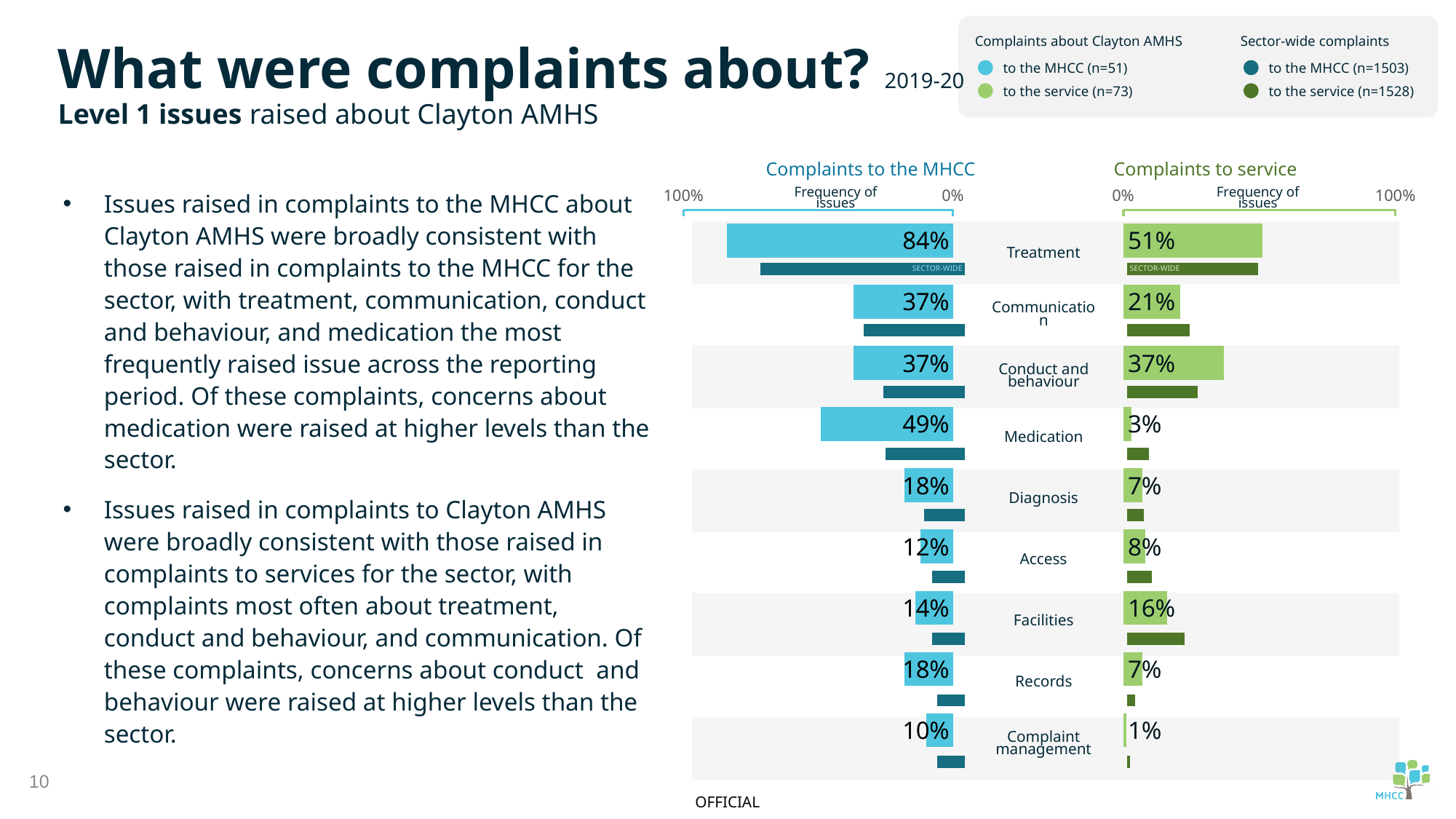
In the 'Complaints to the MHCC' chart, what is the value for Medication? 49% According to the legend, how many complaints to the MHCC about Clayton AMHS were there (n)? 51 In the 'Complaints to service' chart, which category has the lowest frequency of issues? Complaint management How many issue categories are shown in the 'Complaints to the MHCC' chart? 9 In the 'Complaints to the MHCC' chart, what is the difference between the values for Treatment and Medication? 35% In the 'Complaints to service' chart, what is the value for Complaint management? 1% What type of chart is the 'Complaints to service' chart? Bar chart In the 'Complaints to service' chart, what is the frequency of issues for Conduct and behaviour? 37% Which is larger: the Medication value in the 'Complaints to the MHCC' chart or the Medication value in the 'Complaints to service' chart? Complaints to the MHCC In the 'Complaints to the MHCC' chart, which category has the highest frequency of issues? Treatment In the 'Complaints to service' chart, what is the difference between the values for Treatment and Communication? 30% In the 'Complaints to the MHCC' chart, what is the frequency of issues for Treatment? 84%